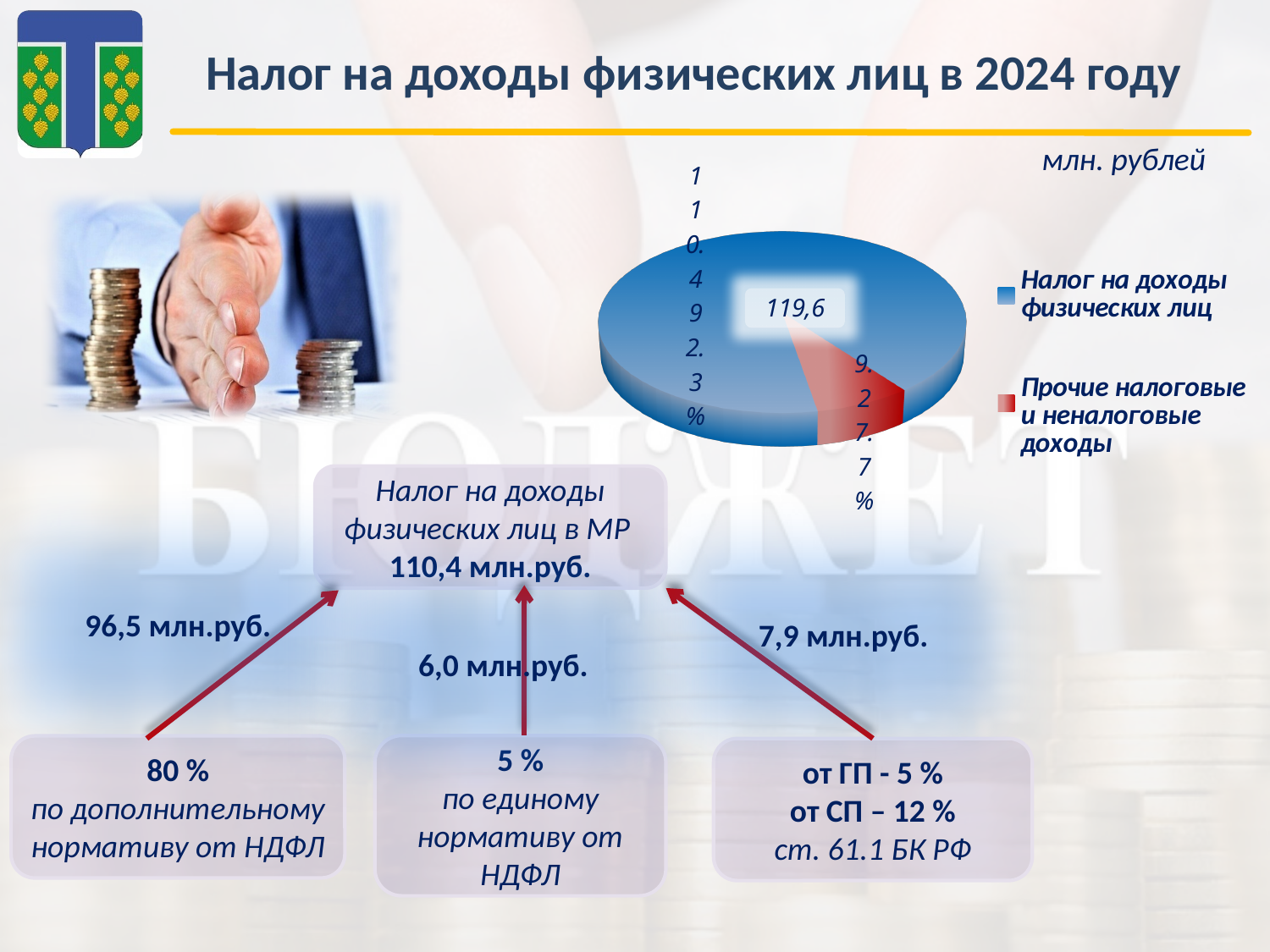
What value is shown for the slice 'Налог на доходы физических лиц' in the pie chart? 110,4 Which slice of the pie chart is the largest? Налог на доходы физических лиц What kind of chart is shown on the slide? pie chart What percentage share does the slice 'Прочие налоговые и неналоговые доходы' have in the pie chart? 7,7% What value is shown for the slice 'Прочие налоговые и неналоговые доходы' in the pie chart? 9,2 What unit of measurement is indicated for the pie chart? млн. рублей What total value is printed in the centre of the pie chart? 119,6 How many slices does the pie chart have? 2 What colour is the slice 'Прочие налоговые и неналоговые доходы' in the pie chart? red What percentage share does the slice 'Налог на доходы физических лиц' have in the pie chart? 92,3% Which slice of the pie chart is the smallest? Прочие налоговые и неналоговые доходы How many series does the legend of the pie chart list? 2